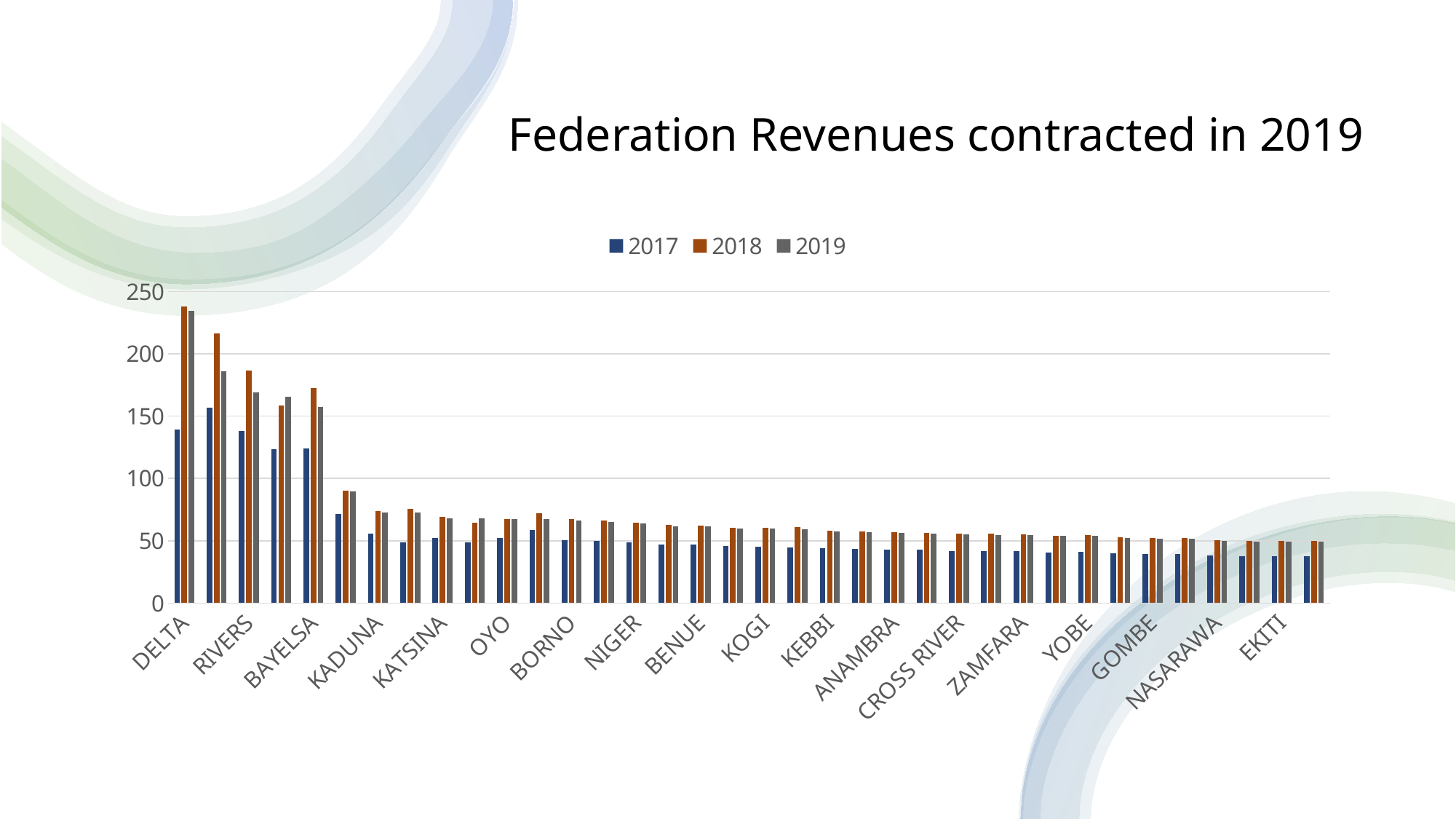
Is the 2019 value for BAYELSA greater or less than 150? greater Is the 2018 value for KADUNA greater or less than 100? less Which years are listed in the legend? 2017, 2018, 2019 Do the values generally rise or fall moving from left to right along the x axis? fall What is the title of the chart? Federation Revenues contracted in 2019 For RIVERS, which is larger: the 2018 value or the 2019 value? 2018 Which state has the highest 2018 value? DELTA Is the 2017 value for DELTA greater or less than 100? greater What kind of chart is shown on the slide? bar chart How many series does the legend list? 3